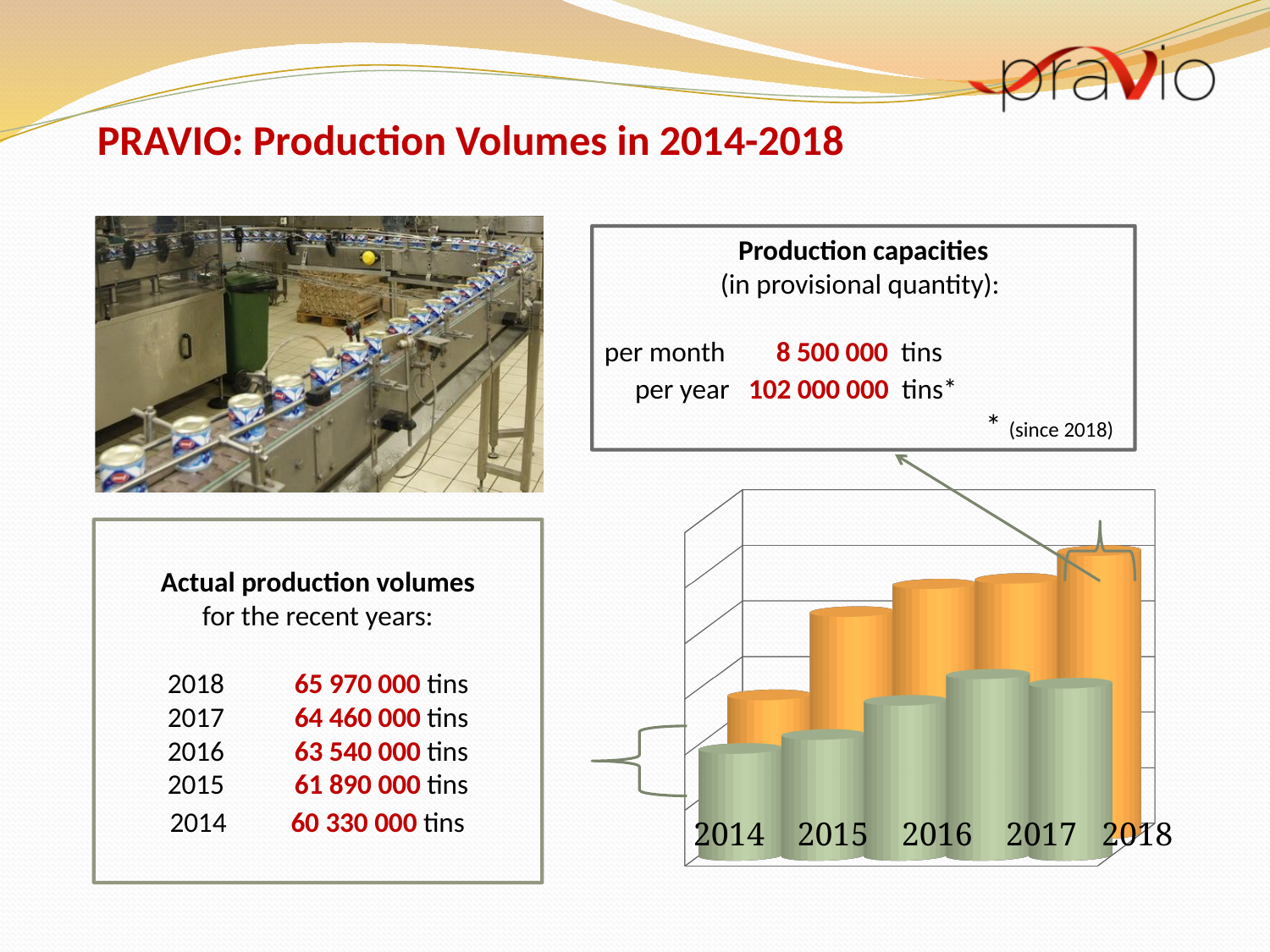
Do the green bars rise or fall from 2014 to 2018? rise In 2018, which bar is taller, the orange one or the green one? the orange one According to the slide, what was the actual production volume in 2018 (the green bar for 2018)? 65 970 000 tins What production capacity per year does the slide link to the 2018 orange bar? 102 000 000 tins What kind of chart is shown on the slide? bar chart Which year has the shortest orange bar? 2014 Which year has the tallest green bar? 2017 Which year is the first category on the x axis of the chart? 2014 Which year has the shortest green bar? 2014 By how many tins did the actual production volume in 2018 exceed that of 2017? 1 510 000 tins How many years are shown along the x axis of the chart? 5 According to the slide, what was the actual production volume in 2014 (the green bar for 2014)? 60 330 000 tins